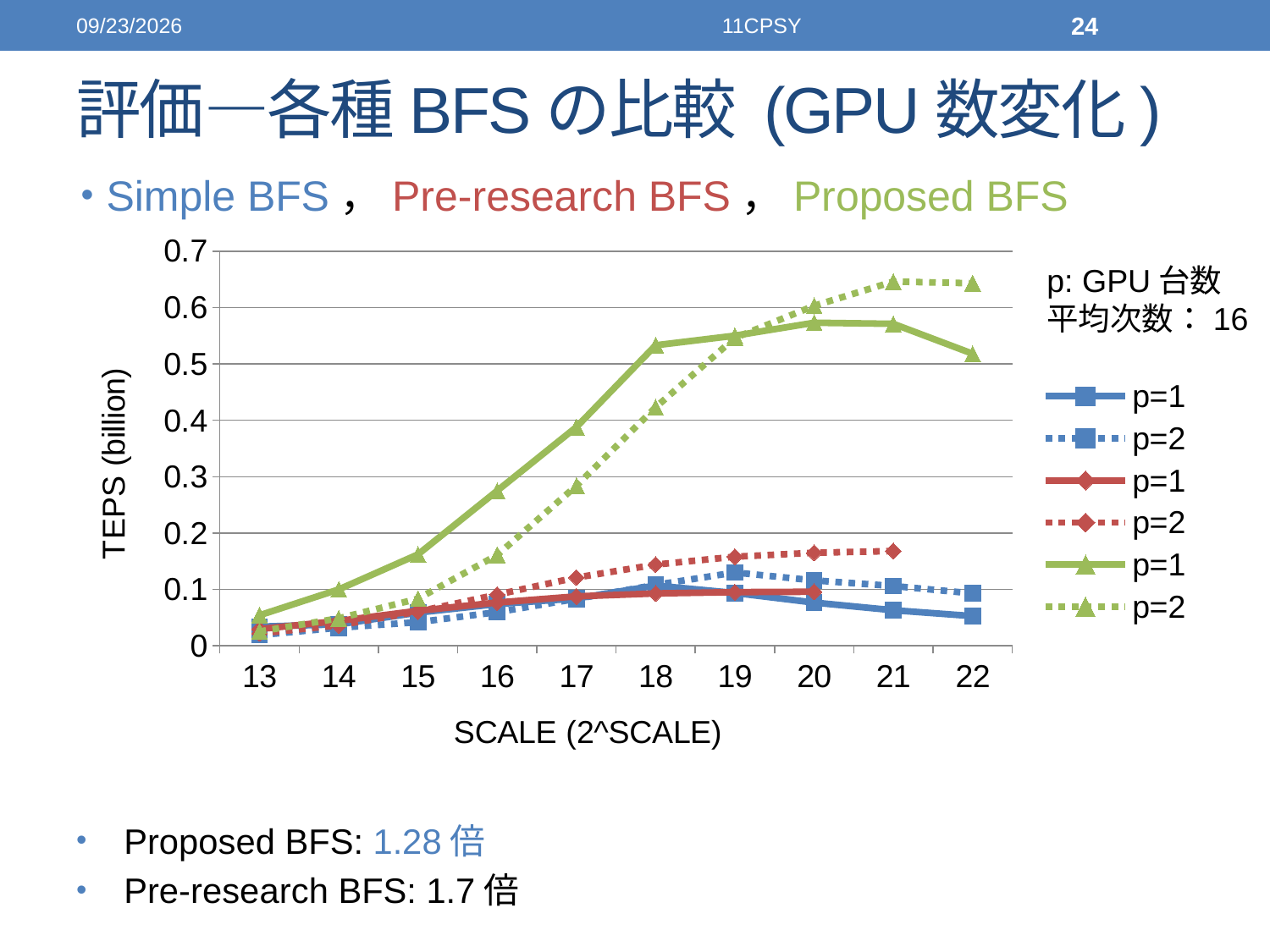
What is the label of the x axis? SCALE (2^SCALE) Is the value of the green dotted p=2 line (Proposed BFS) at SCALE 22 greater or less than 0.6? greater How many SCALE values are plotted along the x axis? 10 Does the green solid p=1 line (Proposed BFS) rise or fall from SCALE 13 to SCALE 20? rise Is the value of the red dotted p=2 line (Pre-research BFS) at SCALE 21 greater or less than 0.2? less What is the label of the y axis? TEPS (billion) What kind of chart is shown on the slide? line chart How many series does the chart's legend list? 6 Does the blue solid p=1 line (Simple BFS) rise or fall from SCALE 19 to SCALE 22? fall Is the value of the blue solid p=1 line (Simple BFS) at SCALE 22 greater or less than 0.1? less At SCALE 18, which is higher: the green solid p=1 line or the green dotted p=2 line? green solid p=1